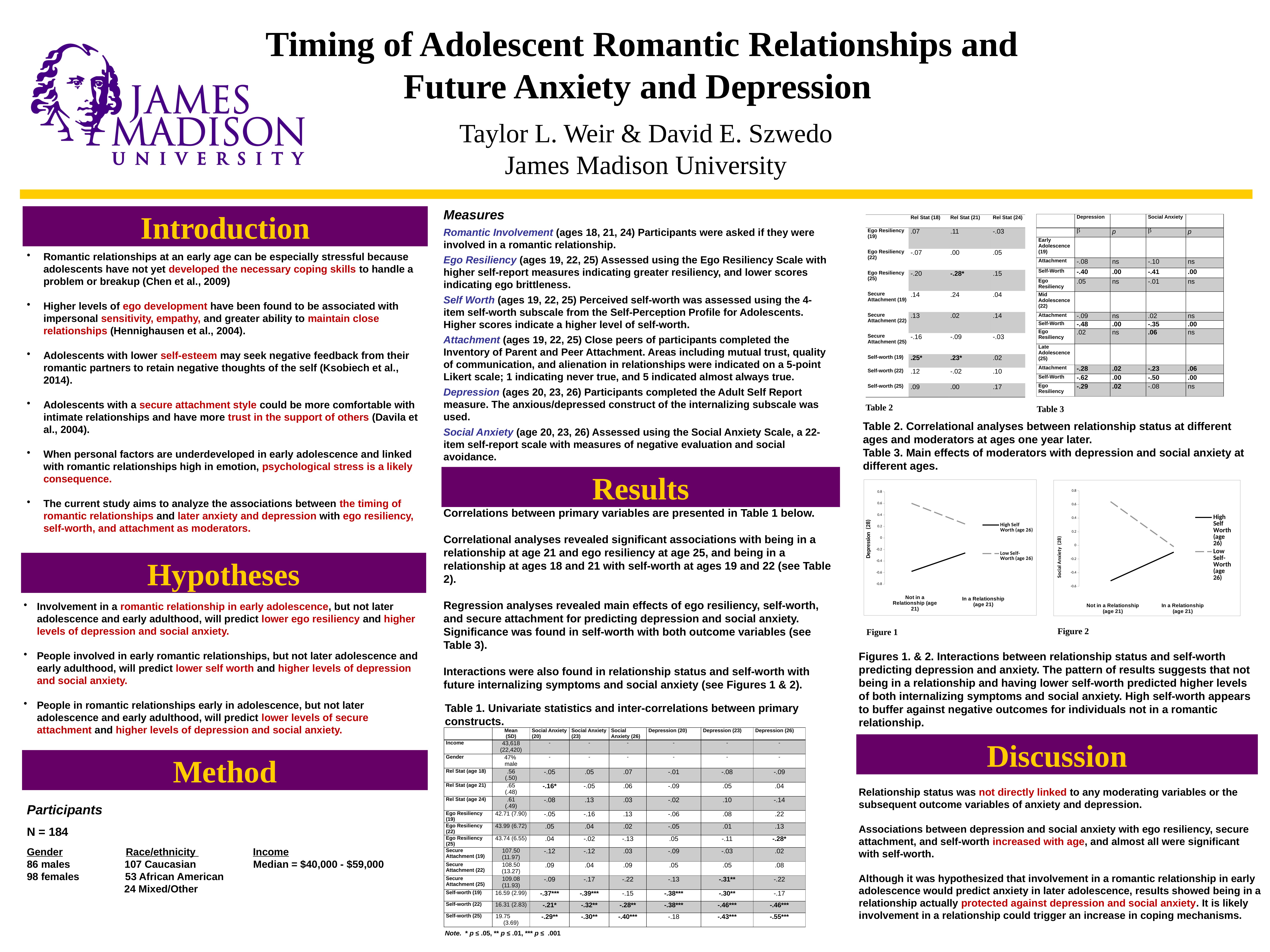
What is the y-axis label of Figure 2? Social Anxiety (28) In Figure 1, does the High Self Worth (age 26) line rise or fall from 'Not in a Relationship' to 'In a Relationship'? rise What is the y-axis label of Figure 1? Depression (28) In Figure 1, is the Low Self-Worth (age 26) value for 'Not in a Relationship (age 21)' greater or less than 0.4? greater In Figure 1, is the High Self Worth (age 26) value for 'Not in a Relationship (age 21)' greater or less than 0? less What kind of chart is Figure 1? line chart In Figure 2, does the Low Self-Worth (age 26) line rise or fall along the x axis? fall How many categories are shown on the x axis of Figure 2? 2 In Figure 1, does the Low Self-Worth (age 26) line rise or fall from 'Not in a Relationship' to 'In a Relationship'? fall In Figure 1, which series has the higher value at 'Not in a Relationship (age 21)'? Low Self-Worth (age 26) In Figure 2, is the Low Self-Worth (age 26) value for 'Not in a Relationship (age 21)' greater or less than 0.4? greater How many series does the legend of Figure 1 list? 2